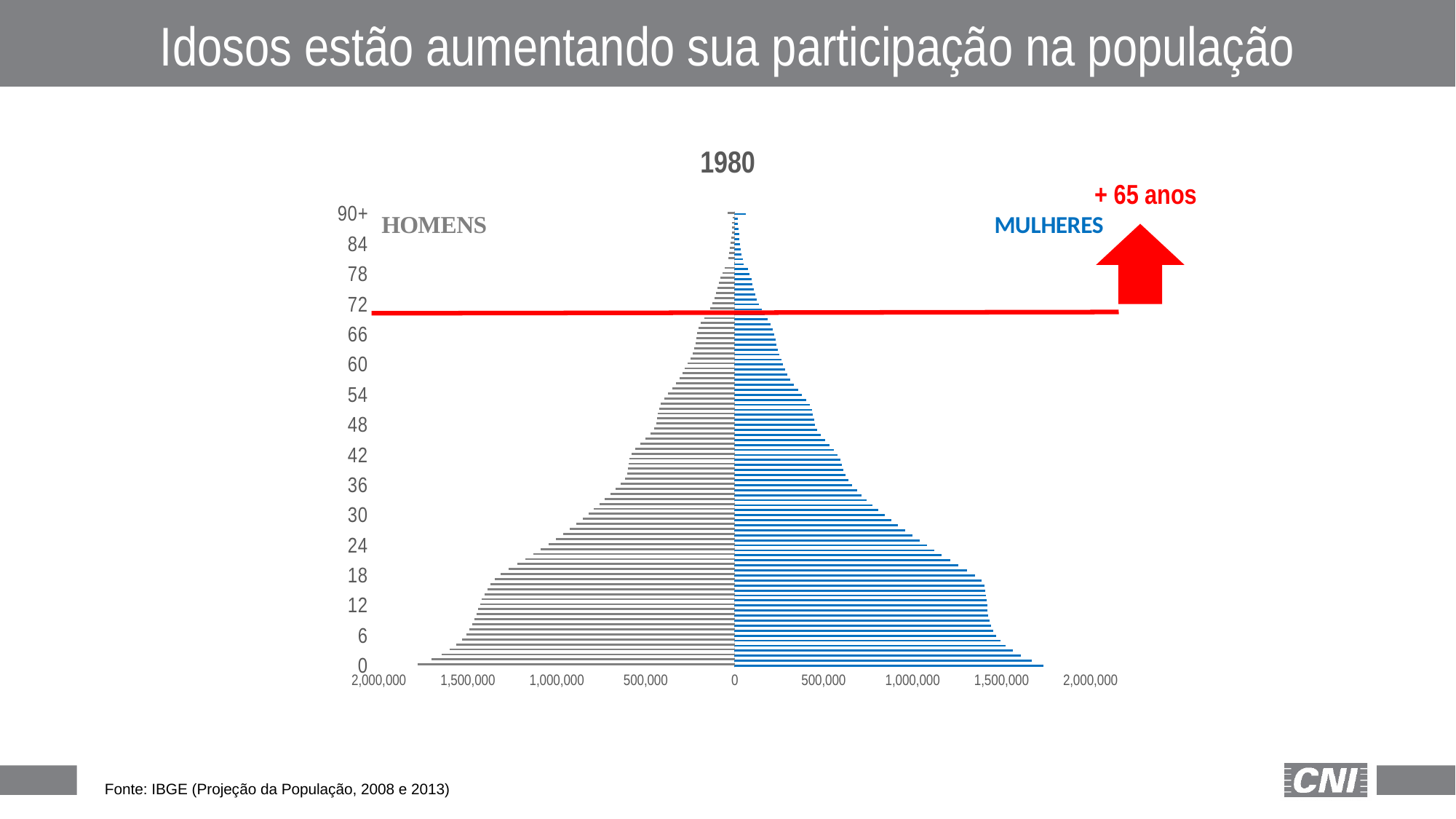
Do the bar lengths rise or fall as age increases from 0 to 90+? fall Is the value for HOMENS at age 36 greater or less than 500,000? greater Is the value for HOMENS at age 0 greater or less than 1,500,000? greater What is the title of the chart? 1980 Is the value for HOMENS at age 60 greater or less than 500,000? less Which colour represents MULHERES in the chart? blue What kind of chart is shown on the slide? bar chart How many series does the chart show? 2